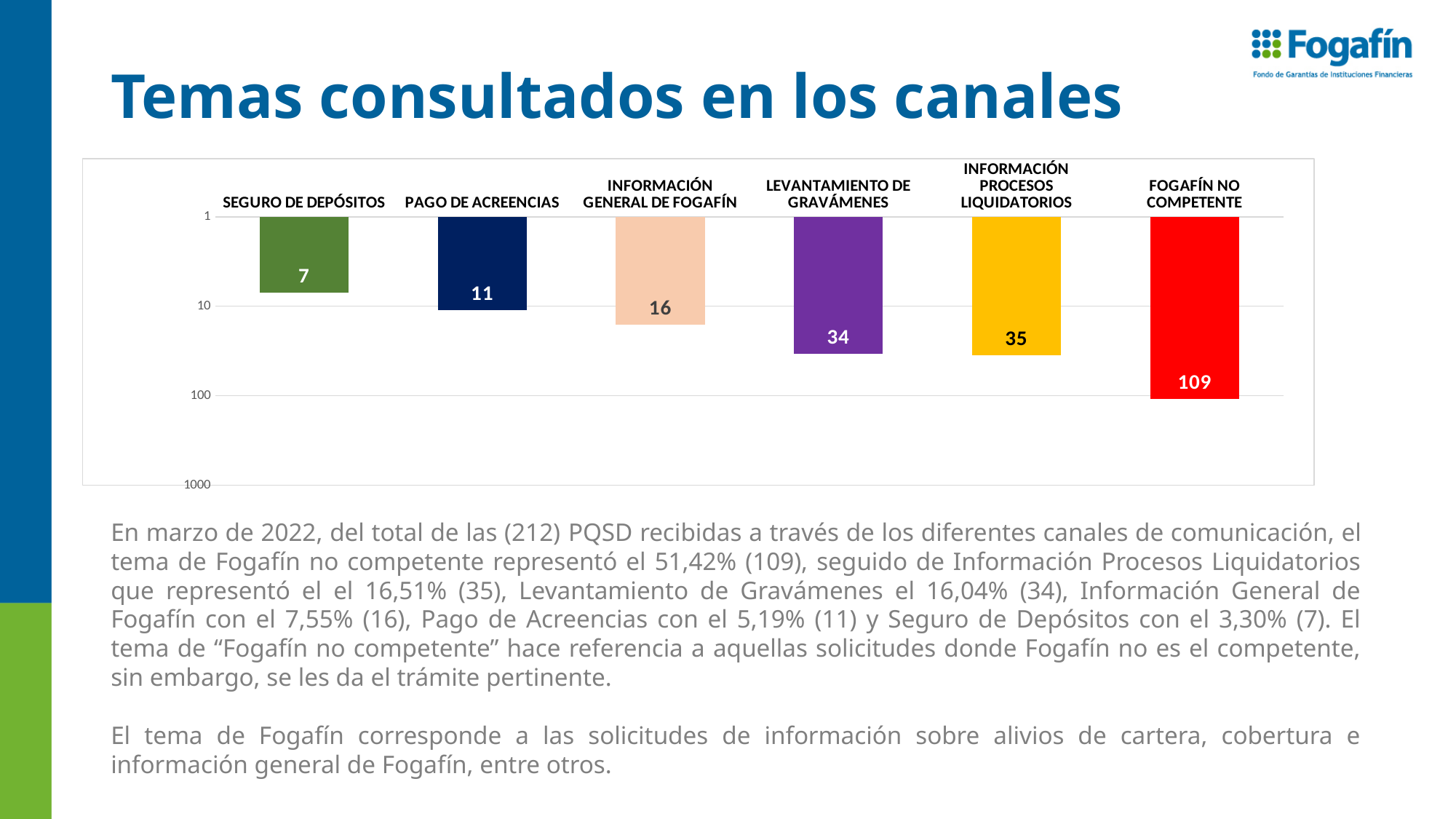
What is the value for INFORMACIÓN GENERAL DE FOGAFÍN? 16 What is the difference between the values for FOGAFÍN NO COMPETENTE and INFORMACIÓN PROCESOS LIQUIDATORIOS? 74 Which category has the highest value? FOGAFÍN NO COMPETENTE What is the value for INFORMACIÓN PROCESOS LIQUIDATORIOS? 35 What kind of chart is shown on the slide? Bar chart Which category has the lowest value? SEGURO DE DEPÓSITOS What is the value for PAGO DE ACREENCIAS? 11 What is the value for LEVANTAMIENTO DE GRAVÁMENES? 34 Do the values rise or fall moving from left to right across the categories? Rise Which is larger, the value for INFORMACIÓN PROCESOS LIQUIDATORIOS or the value for LEVANTAMIENTO DE GRAVÁMENES? INFORMACIÓN PROCESOS LIQUIDATORIOS What is the value for SEGURO DE DEPÓSITOS? 7 How many categories (topics) are shown in the chart? 6